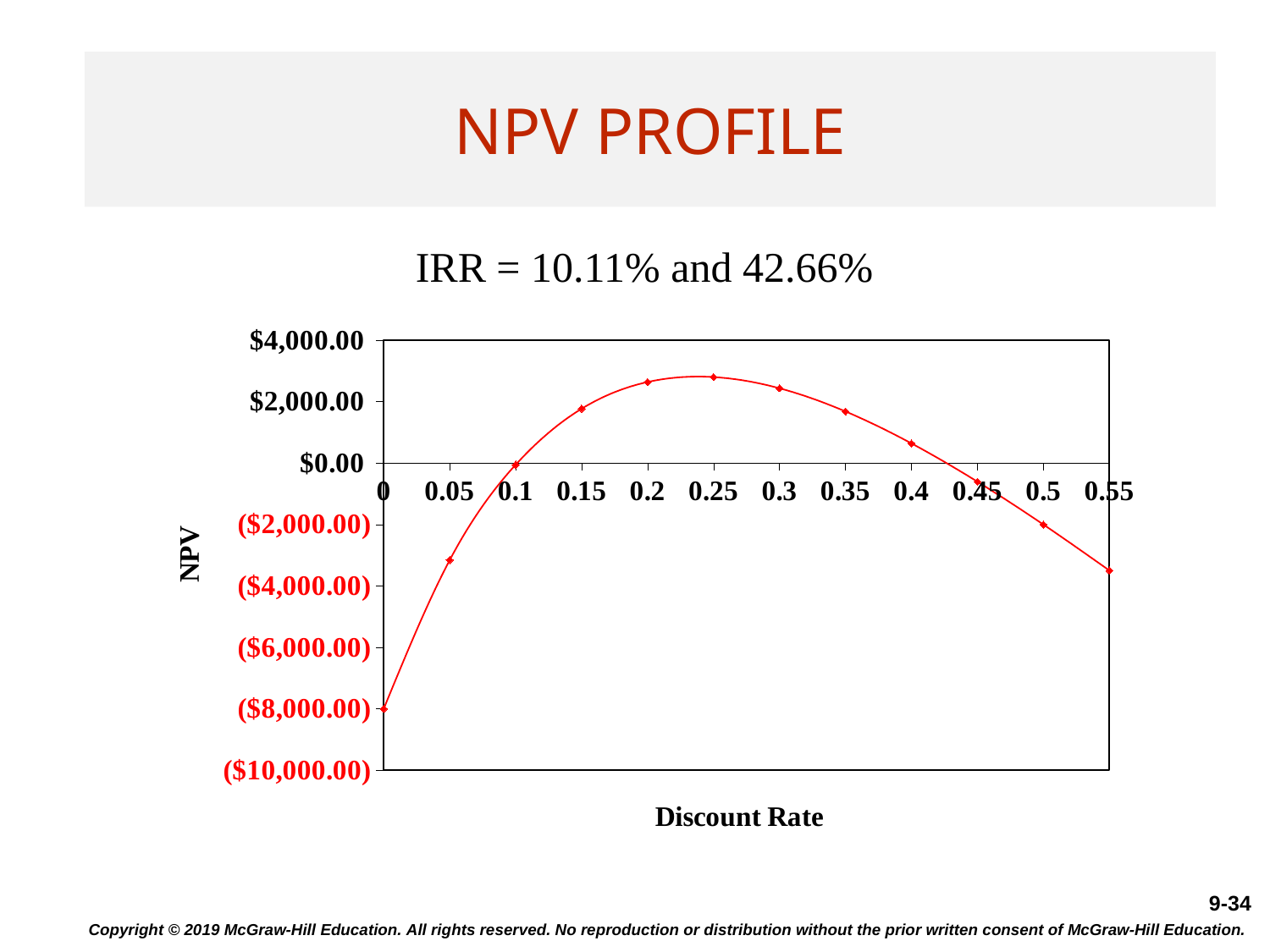
What is the label on the horizontal axis of the chart? Discount Rate Is the NPV at a discount rate of 0.55 greater or less than ($2,000.00)? less What kind of chart is shown on the slide? line chart Is the NPV at a discount rate of 0.05 greater or less than ($2,000.00)? less How does the NPV change as the discount rate increases from 0 to 0.55? It rises to a peak around 0.25, then falls Is the NPV at a discount rate of 0.4 greater or less than $0.00? greater At which discount rate does the NPV reach its highest value? 0.25 Which discount rate has the higher NPV, 0.05 or 0.5? 0.5 How many data points are plotted on the NPV profile line? 12 At which discount rate is the NPV lowest? 0 Which discount rate has the higher NPV, 0.2 or 0.4? 0.2